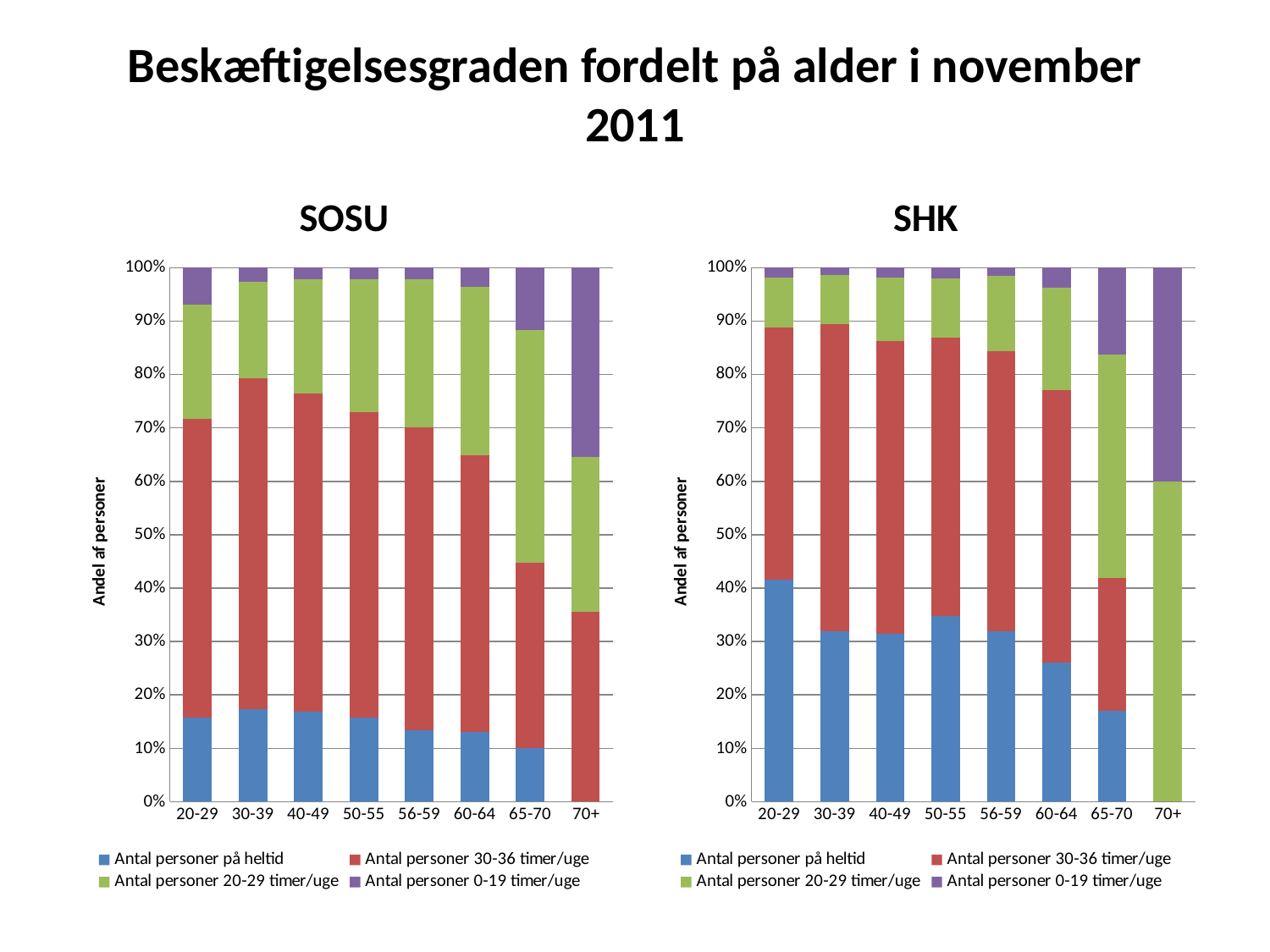
How many age groups are shown on the x axis of the SHK chart? 8 What kind of chart is the SOSU chart? stacked bar chart In the SHK chart, is the share of 'Antal personer på heltid' for 20-29 greater or less than 30%? greater In the SOSU chart, is the share of 'Antal personer på heltid' for 65-70 greater or less than 20%? less In the SHK chart, which age group has the largest share of 'Antal personer på heltid'? 20-29 How many series does the legend of the SOSU chart list? 4 In the SHK chart, which has the larger share of 'Antal personer på heltid': 20-29 or 60-64? 20-29 What is the y-axis title of the SHK chart? Andel af personer In the SHK chart, is the share of 'Antal personer på heltid' for 65-70 greater or less than 20%? less In the SOSU chart, which series is shown in purple? Antal personer 0-19 timer/uge In the SOSU chart, which has the larger share of 'Antal personer på heltid': 30-39 or 65-70? 30-39